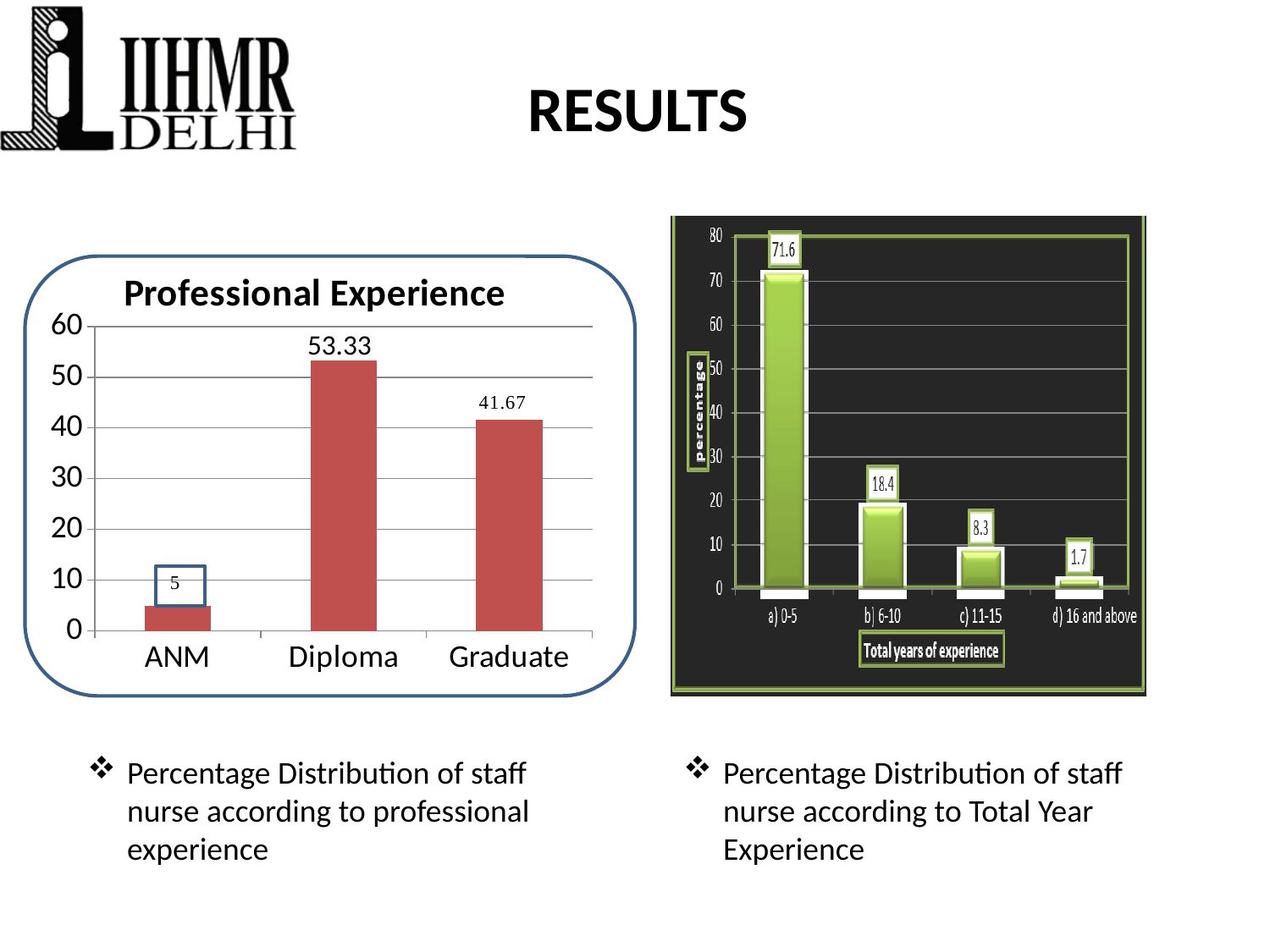
In the 'Professional Experience' chart, how many categories are shown on the x axis? 3 What kind of chart is the chart on the right (Total years of experience)? bar chart In the chart on the right (Total years of experience), what is the difference between the values for a) 0-5 and b) 6-10? 53.2 In the 'Professional Experience' chart, which category has the highest value? Diploma In the chart on the right (Total years of experience), do the values rise or fall from left to right along the x axis? fall In the 'Professional Experience' chart, which category has the lowest value? ANM In the 'Professional Experience' chart, what is the value for ANM? 5 In the chart on the right (Total years of experience), what is the value for a) 0-5? 71.6 In the 'Professional Experience' chart, what is the difference between the values for Diploma and Graduate? 11.66 In the chart on the right (Total years of experience), what is the value for c) 11-15? 8.3 In the 'Professional Experience' chart, what is the value for Diploma? 53.33 In the chart on the right (Total years of experience), which category has the lowest value? d) 16 and above